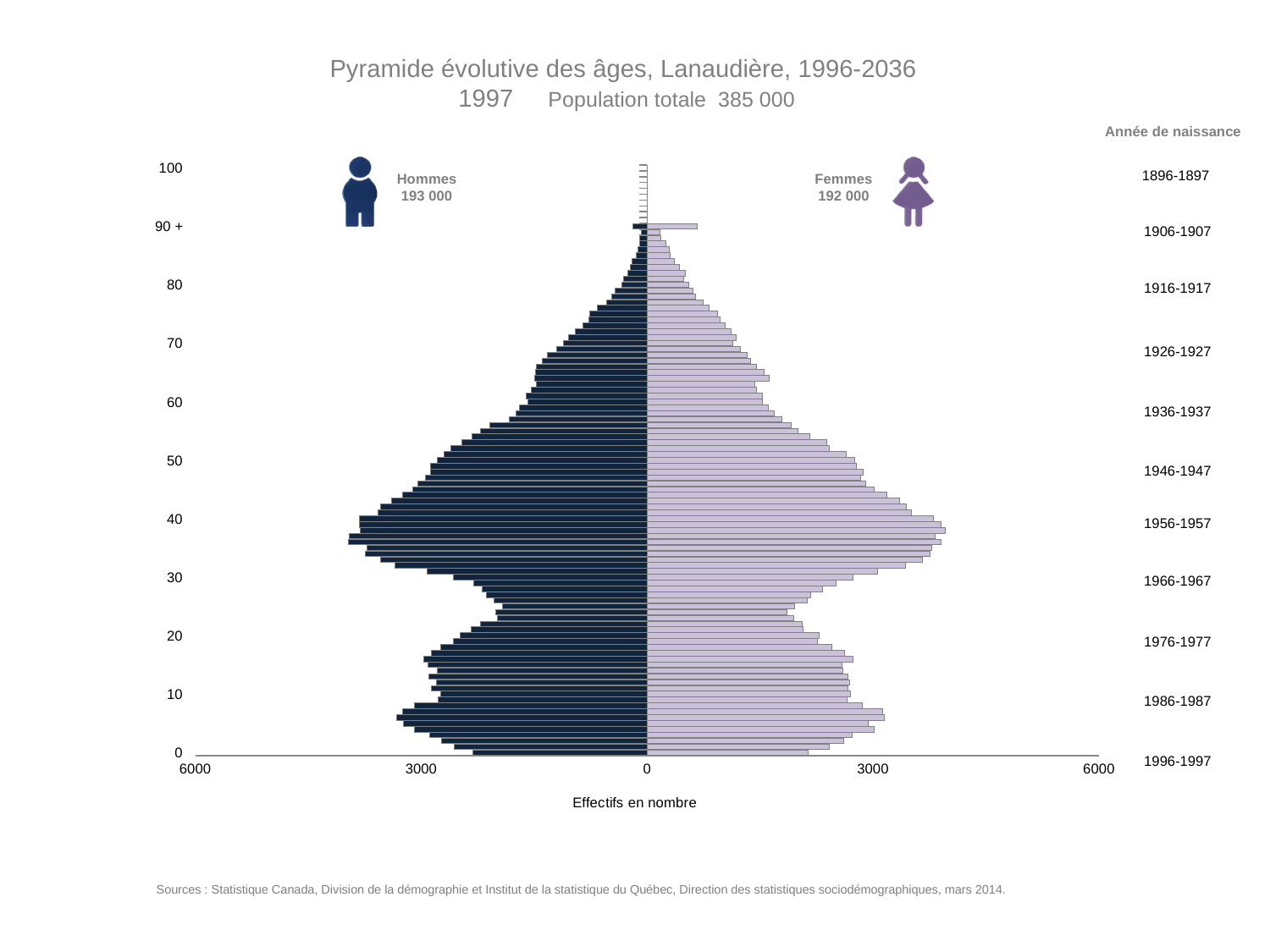
What kind of chart is shown on the slide? bar chart What is the label of the horizontal axis? Effectifs en nombre What is the number of Hommes shown on the chart? 193 000 Is the value for Hommes at age 70 greater or less than 3000? less Is the value for Femmes at age 25 greater or less than 3000? less Which group is larger, Hommes or Femmes? Hommes From age 40 up to age 90, do the bar lengths rise or fall? fall Which is larger, the bar for Hommes at age 40 or the bar for Hommes at age 70? age 40 What is the total population shown for 1997? 385 000 What is the difference between the number of Hommes and the number of Femmes? 1 000 What is the number of Femmes shown on the chart? 192 000 Is the value for Hommes at age 38 greater or less than 3000? greater